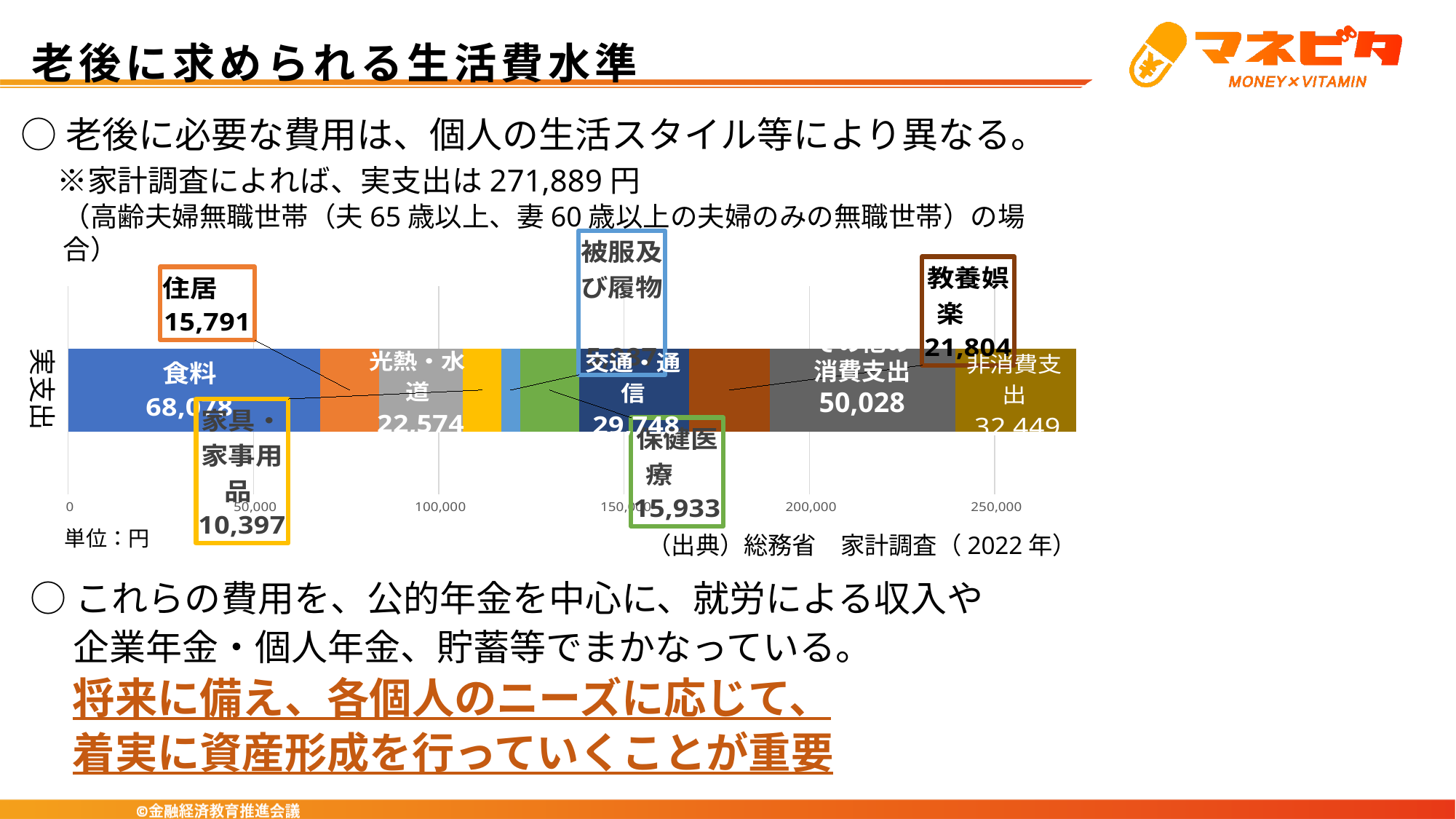
What is the value for 住居 in the 実支出 bar chart? 15,791 What is the value for 家具・家事用品 in the 実支出 bar chart? 10,397 What is the value for 保健医療 in the 実支出 bar chart? 15,933 Which segment of the 実支出 bar is the largest? 食料 What is the value for 光熱・水道 in the 実支出 bar chart? 22,574 What kind of chart is shown on the slide? Stacked horizontal bar chart What is the value for その他の消費支出 in the 実支出 bar chart? 50,028 What is the value for 交通・通信 in the 実支出 bar chart? 29,748 What is the value for 非消費支出 in the 実支出 bar chart? 32,449 What is the difference between 非消費支出 and 教養娯楽 in the 実支出 bar chart? 10,645 Which is larger in the 実支出 bar chart, 交通・通信 or 光熱・水道? 交通・通信 What is the value for 教養娯楽 in the 実支出 bar chart? 21,804